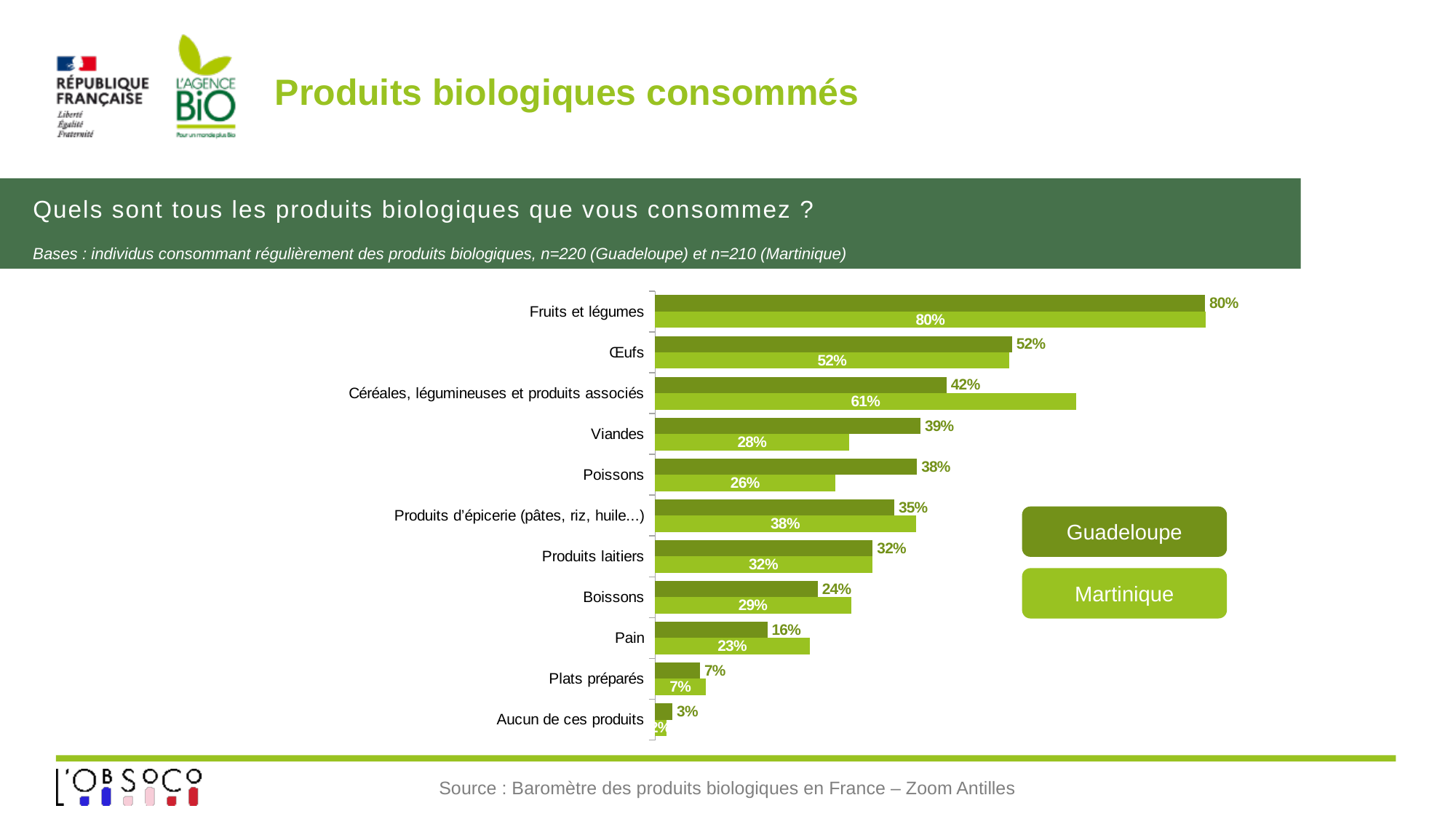
For Poissons, which is larger, the Guadeloupe value or the Martinique value? Guadeloupe What is the difference between the Martinique and Guadeloupe values for Céréales, légumineuses et produits associés? 19% How many series does the legend list? 2 What is the value for Guadeloupe for Viandes? 39% How many product categories are shown in the chart? 11 Which series is shown in the darker green colour? Guadeloupe What kind of chart is shown on the slide? bar chart What is the value for Martinique for Céréales, légumineuses et produits associés? 61% What is the value for Guadeloupe for Fruits et légumes? 80% Which category has the highest value for Guadeloupe? Fruits et légumes What is the value for Martinique for Pain? 23% Which category has the lowest value for Guadeloupe? Aucun de ces produits